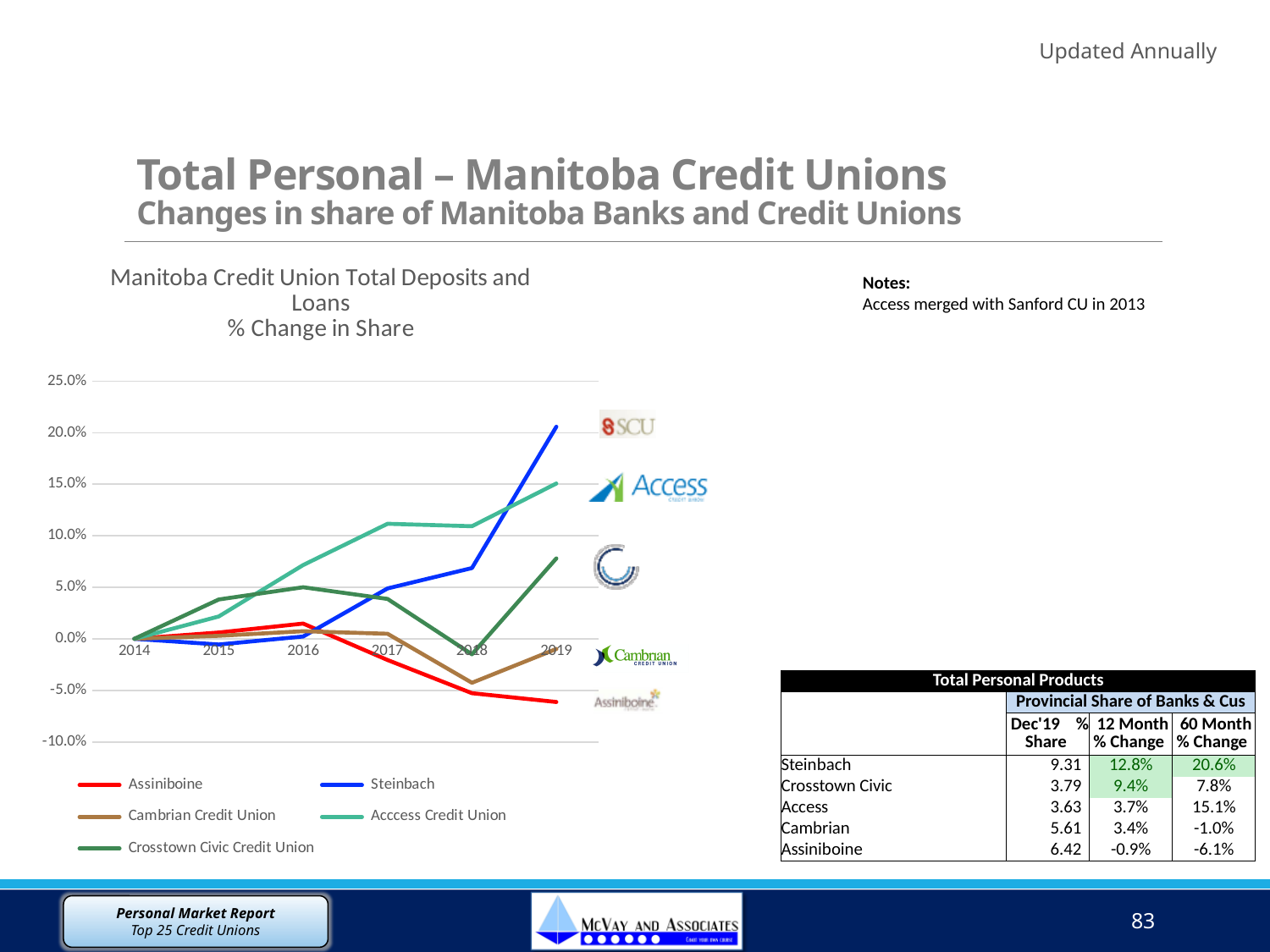
In 2019, which is larger: the value for Steinbach or the value for Acccess Credit Union? Steinbach Does the Steinbach line rise or fall from 2016 to 2019? rise Is the value for Acccess Credit Union in 2019 greater or less than 10.0%? greater Is the value for Assiniboine in 2019 greater or less than -5.0%? less Which series has the lowest value in 2019? Assiniboine How many years are plotted along the x axis of the chart? 6 Which series has the highest value in 2019? Steinbach How many series does the chart legend list? 5 Which series is drawn in red on the chart? Assiniboine Is the value for Crosstown Civic Credit Union in 2019 greater or less than 5.0%? greater What kind of chart is shown on the slide? line chart